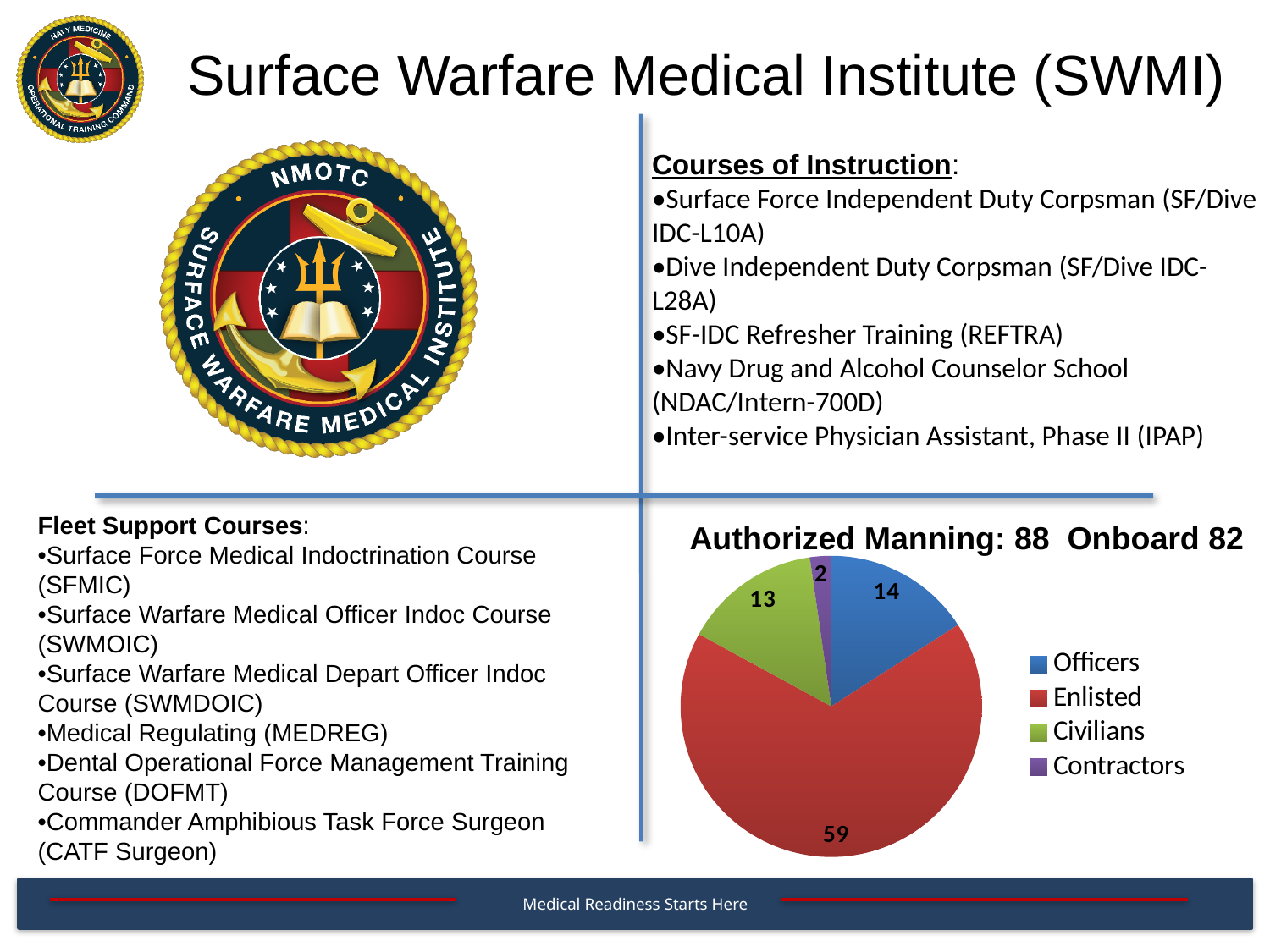
What is the value for Civilians in the pie chart? 13 What is the value for Contractors in the pie chart? 2 Which is larger in the pie chart, Officers or Civilians? Officers What is the value for Officers in the pie chart? 14 What is the title of the pie chart? Authorized Manning: 88 Onboard 82 What is the value for Enlisted in the pie chart? 59 How many categories does the pie chart legend list? 4 Which category has the smallest slice in the pie chart? Contractors What is the difference between the Enlisted and Officers values in the pie chart? 45 What type of chart is shown on the slide? Pie chart What is the total of all slices in the pie chart? 88 Which category has the largest slice in the pie chart? Enlisted